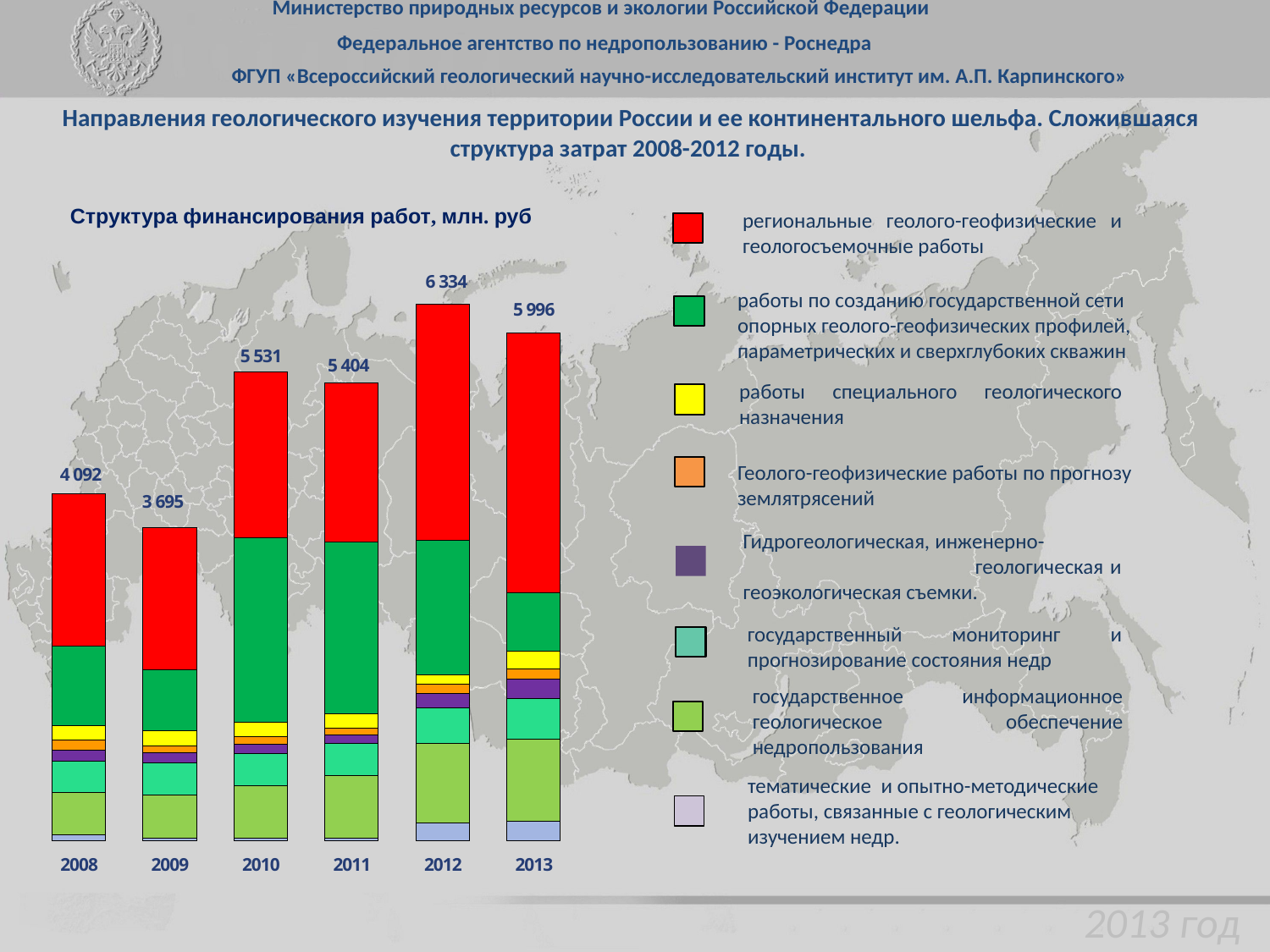
What is the difference between the totals for 2012 and 2013? 338 What is the difference between the totals for 2010 and 2011? 127 What kind of chart is shown on the slide? Stacked bar chart What is the total value shown for 2013? 5 996 What is the total value shown for 2008? 4 092 How many series does the legend list? 8 Which is larger, the total for 2010 or the total for 2013? 2013 How many years are shown on the x axis of the chart? 6 What is the total value shown for 2012 in the chart "Структура финансирования работ, млн. руб"? 6 334 Which year has the lowest total funding? 2009 What is the total value shown for 2009? 3 695 Which year has the highest total funding? 2012